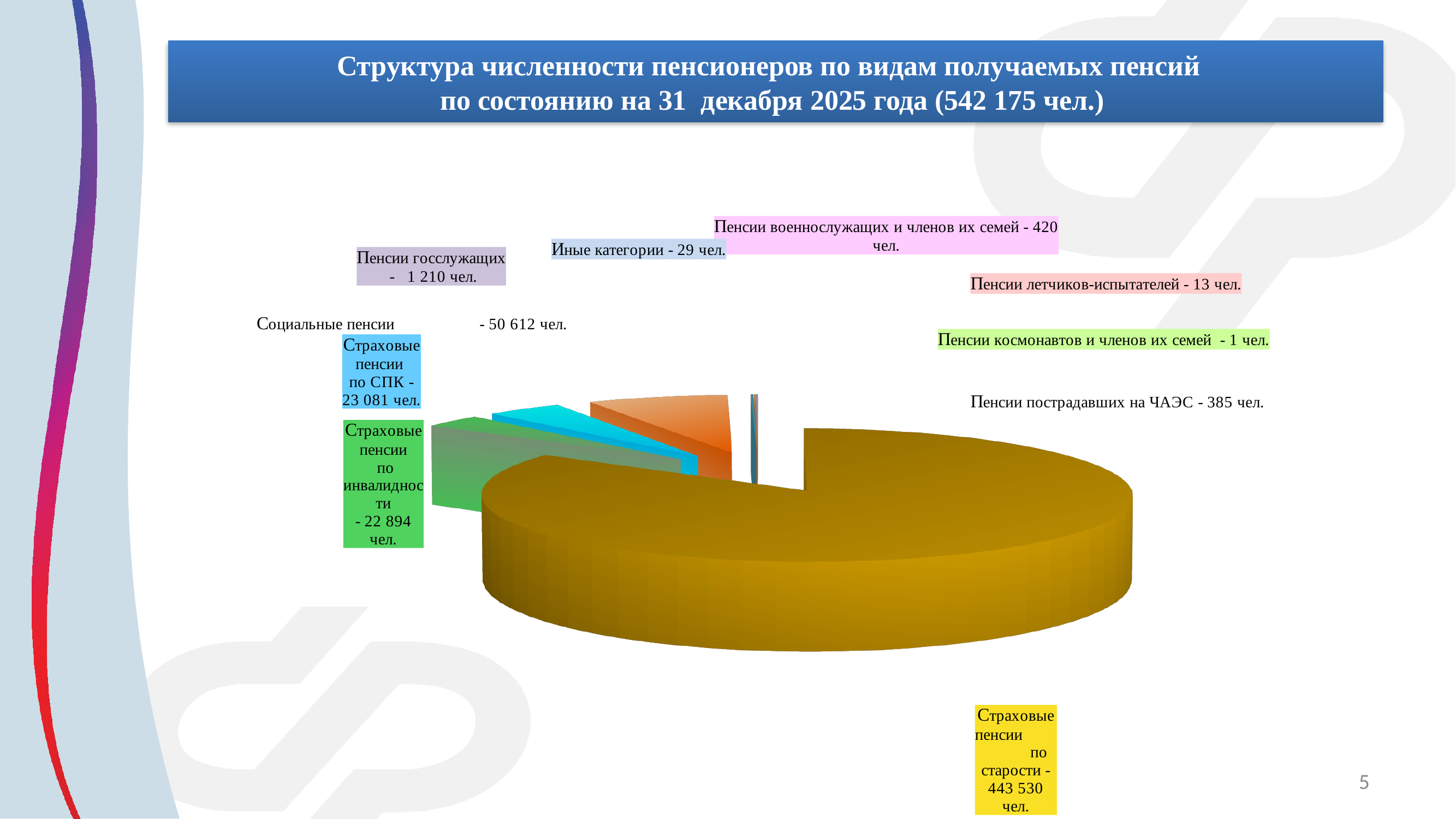
What total number of pensioners is stated in the chart title? 542 175 чел. Which pension category has the smallest number of recipients? Пенсии космонавтов и членов их семей How many pension categories are shown in the chart? 10 How many people receive Страховые пенсии по старости according to the chart? 443 530 чел. What is the value for Пенсии пострадавших на ЧАЭС? 385 чел. What is the difference between Социальные пенсии and Страховые пенсии по СПК? 27 531 чел. Which pension category has the largest number of recipients? Страховые пенсии по старости What is the value shown for Социальные пенсии? 50 612 чел. What kind of chart is shown on the slide? Pie chart What is the difference between Страховые пенсии по СПК and Страховые пенсии по инвалидности? 187 чел. Which is larger: Страховые пенсии по СПК or Страховые пенсии по инвалидности? Страховые пенсии по СПК How many people receive Пенсии госслужащих? 1 210 чел.